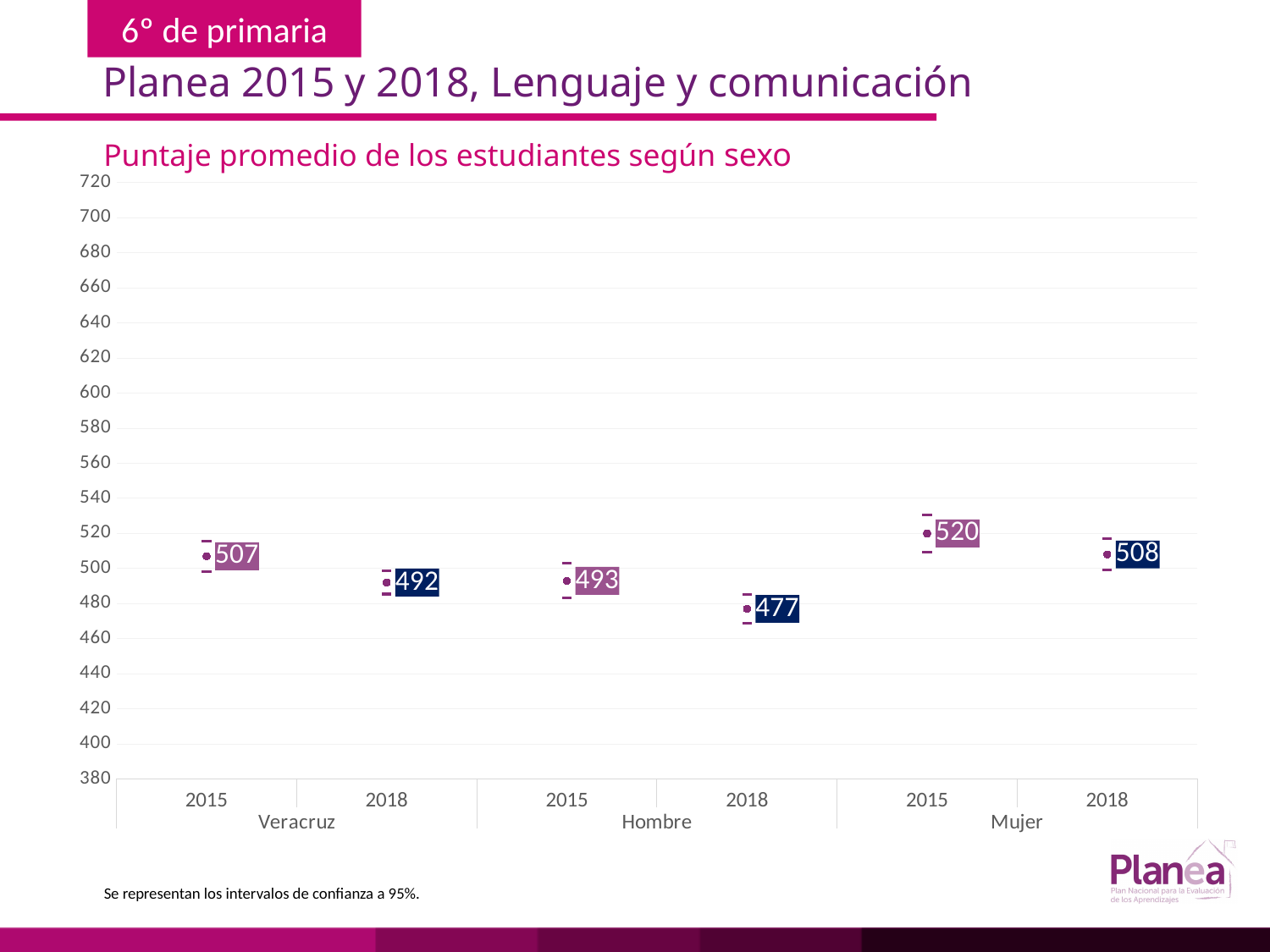
Is the Hombre score in 2018 greater or less than 480? less What is the average score for Veracruz in 2015? 507 How many data points are plotted on the chart? 6 What is the average score for Veracruz in 2018? 492 What is the difference between the Hombre score in 2015 and in 2018? 16 What is the average score for Mujer in 2015? 520 What is the title of the chart? Puntaje promedio de los estudiantes según sexo Which is larger, the Veracruz score in 2018 or the Hombre score in 2015? Hombre 2015 Which group and year has the highest average score? Mujer 2015 Which group and year has the lowest average score? Hombre 2018 What is the average score for Hombre in 2018? 477 What is the difference between the Mujer score in 2015 and in 2018? 12